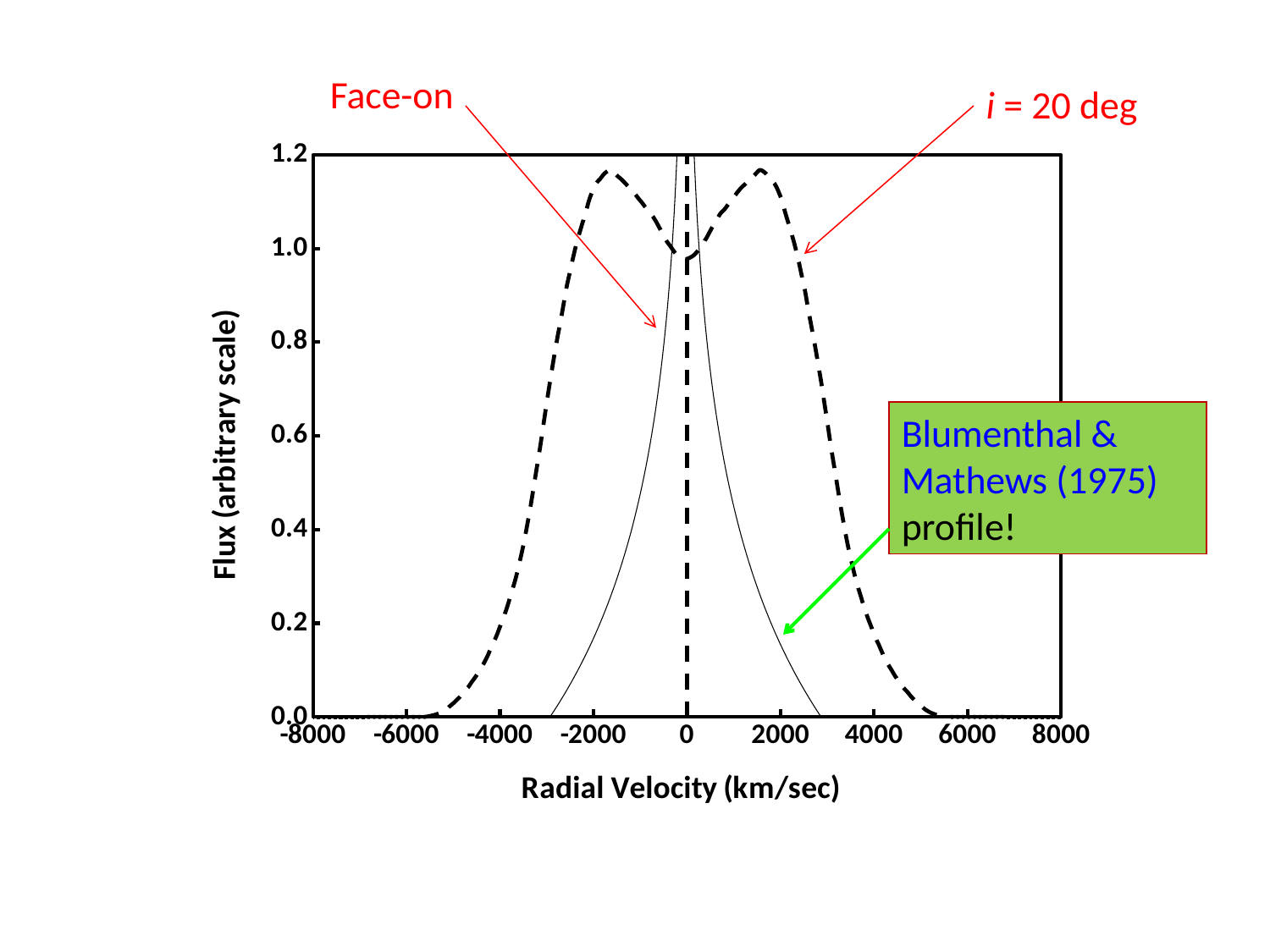
Is the flux of the i = 20 deg curve at a radial velocity of 4000 km/sec greater or less than 0.6? less How many curves are plotted on the chart? 2 At a radial velocity of 2000 km/sec, which curve has the higher flux, Face-on or i = 20 deg? i = 20 deg Is the flux of the i = 20 deg curve at a radial velocity of -2000 km/sec greater or less than 0.8? greater What is the label of the x axis? Radial Velocity (km/sec) Does the flux of the Face-on curve rise or fall as radial velocity increases from -3000 to 0 km/sec? rise Does the flux of the i = 20 deg curve rise or fall as radial velocity increases from 2000 to 6000 km/sec? fall How many tick labels are shown on the x axis? 9 What is the label of the y axis? Flux (arbitrary scale) At a radial velocity of 0 km/sec, which curve has the higher flux, Face-on or i = 20 deg? Face-on Is the flux of the Face-on curve at a radial velocity of 2000 km/sec greater or less than 0.4? less What kind of chart is shown on the slide? line chart